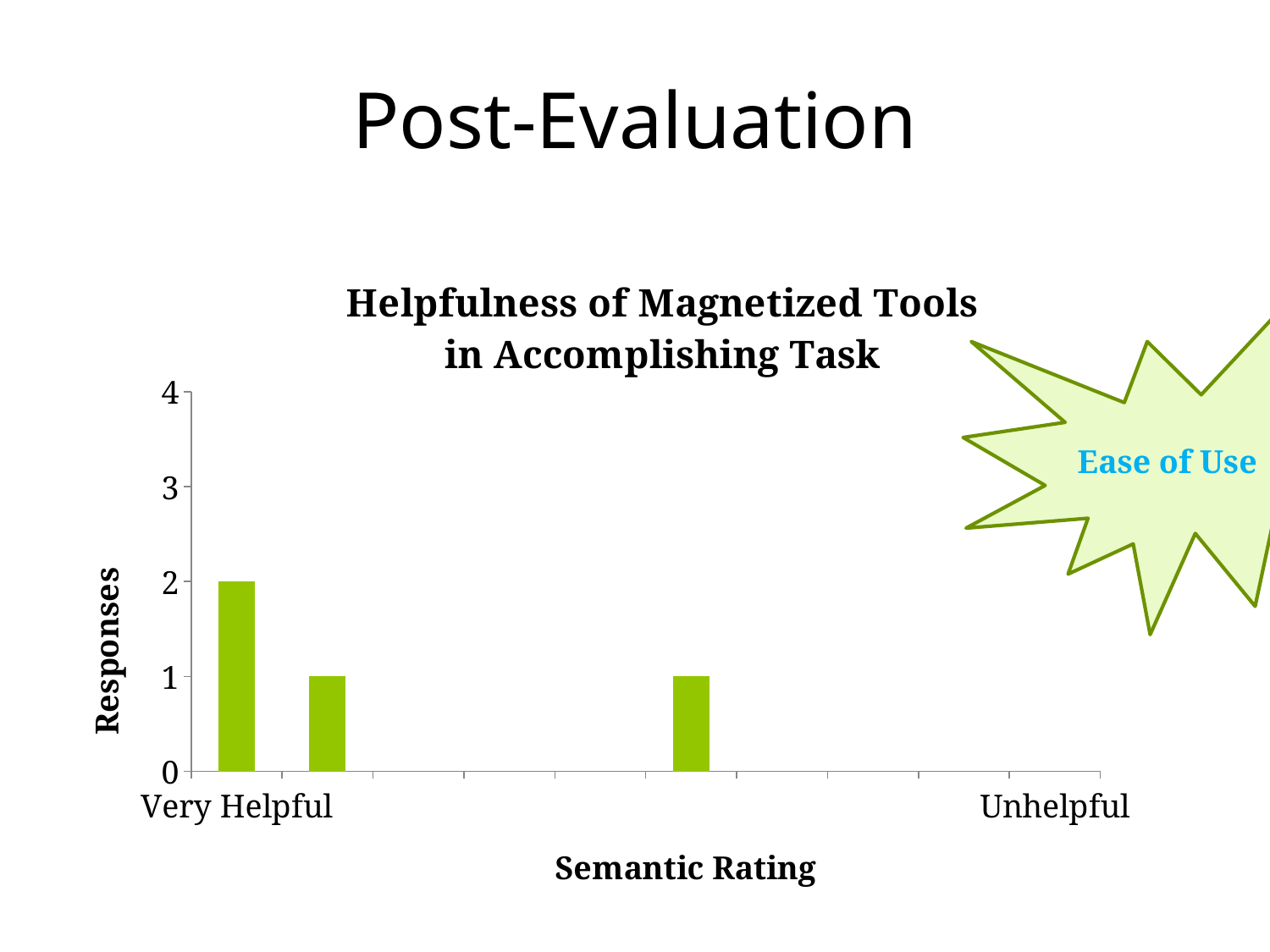
What is the highest value shown on the Responses axis? 4 What is the label of the vertical axis? Responses Do the response counts generally rise or fall moving from Very Helpful toward Unhelpful? fall What is the title of the chart? Helpfulness of Magnetized Tools in Accomplishing Task Is the value for Very Helpful greater or less than 1? greater What kind of chart is shown on the slide? bar chart How many responses are shown for the Very Helpful rating? 2 How many responses are shown for the Unhelpful rating? 0 Which rating category has the highest number of responses? Very Helpful Is the value for Very Helpful greater or less than 3? less How many bars are plotted in the chart? 3